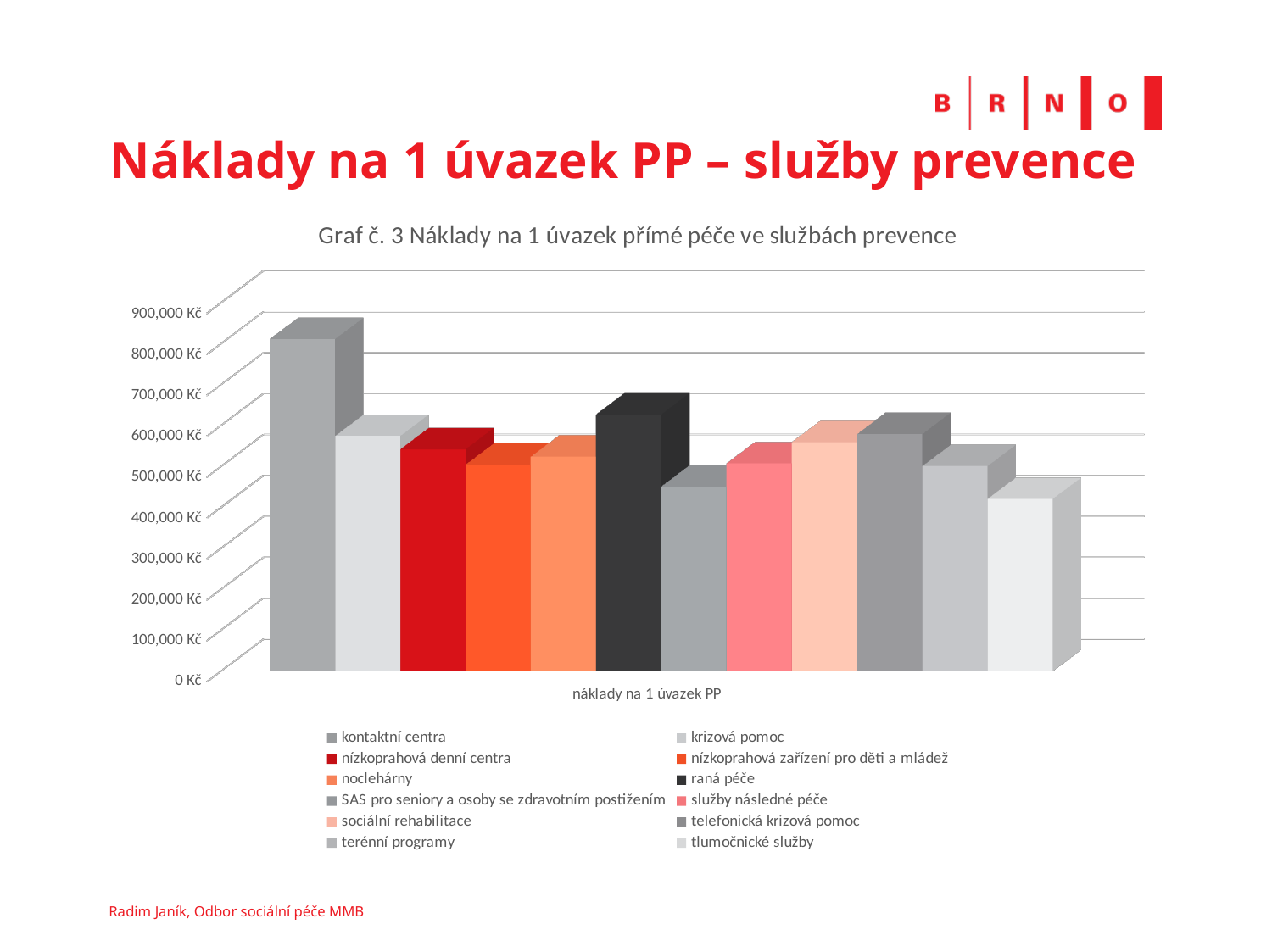
Is the value for tlumočnické služby greater or less than 600,000 Kč? less Which service has the highest cost per 1 úvazek PP? kontaktní centra What is the title of the chart? Graf č. 3 Náklady na 1 úvazek přímé péče ve službách prevence Is the value for kontaktní centra greater or less than 700,000 Kč? greater What kind of chart is shown on the slide? bar chart Which service has the lowest cost per 1 úvazek PP? tlumočnické služby Is the value for SAS pro seniory a osoby se zdravotním postižením greater or less than 600,000 Kč? less Which is larger, the value for raná péče or the value for tlumočnické služby? raná péče What colour is the bar for raná péče? black How many series does the legend list? 12 Which is larger, the value for kontaktní centra or the value for raná péče? kontaktní centra